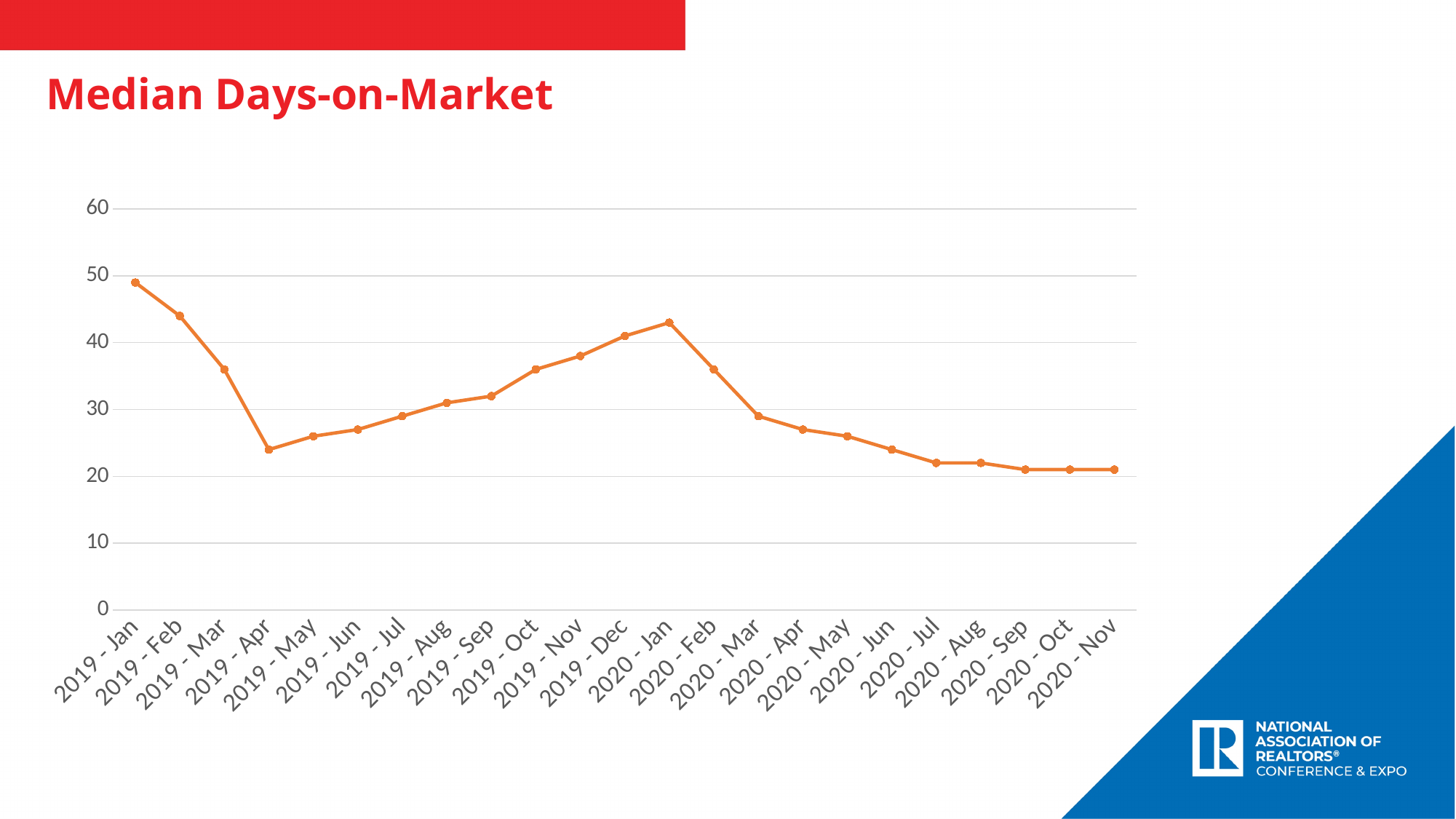
What kind of chart is shown on the slide? Line chart What is the title of the chart? Median Days-on-Market Is the value for 2020 - Jan greater or less than 40? greater Which is larger, the value for 2019 - Jan or 2020 - Jan? 2019 - Jan Is the value for 2019 - Jan greater or less than 40? greater Do the values rise or fall from 2019 - Apr to 2020 - Jan? Rise Do the values rise or fall from 2020 - Jan to 2020 - Nov? Fall How many monthly data points are plotted on the chart? 23 Is the value for 2019 - Apr greater or less than 30? less Which is larger, the value for 2019 - Apr or 2019 - Oct? 2019 - Oct Which month has the highest median days-on-market? 2019 - Jan